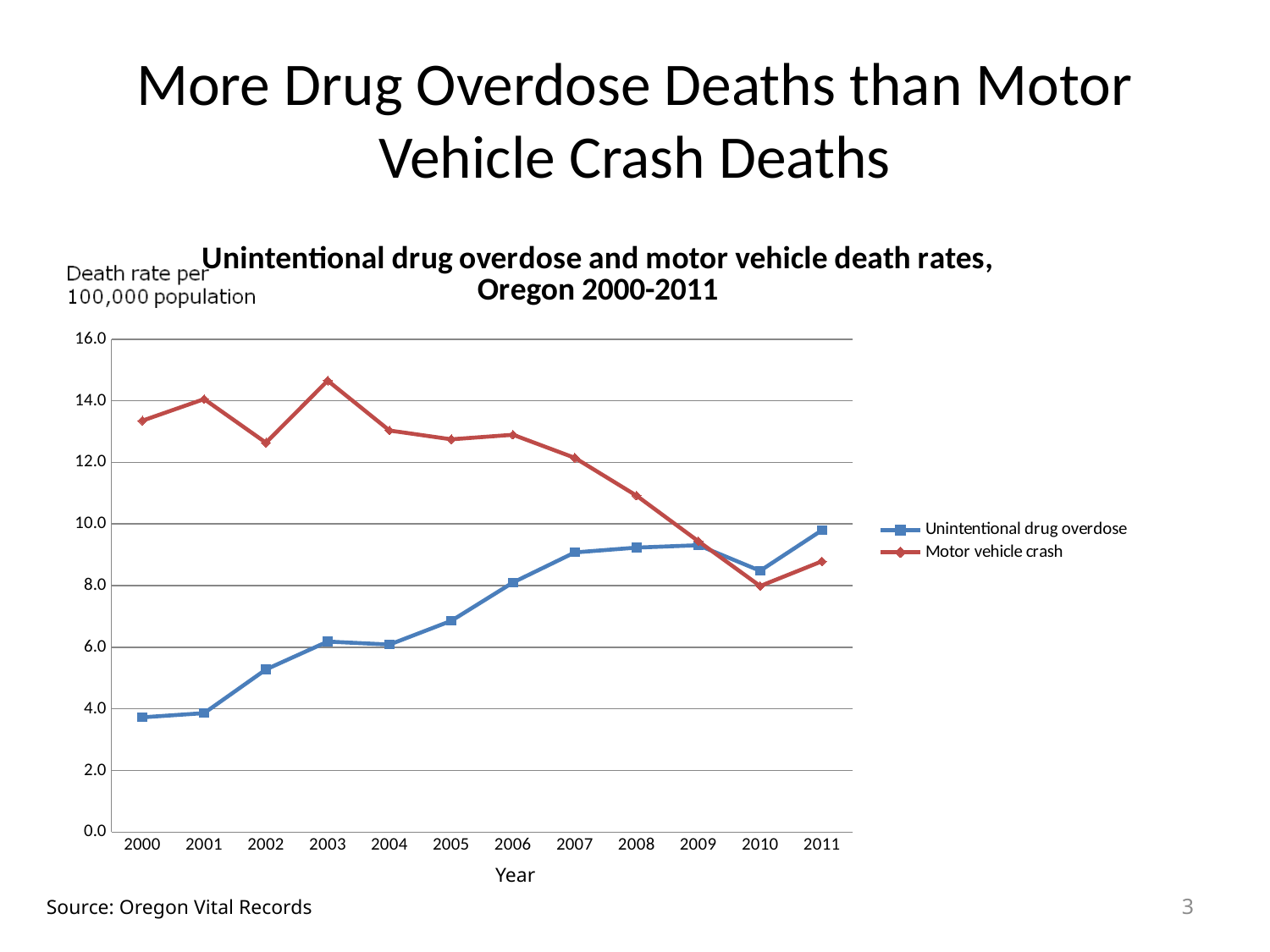
What is the label on the y axis of the chart? Death rate per 100,000 population Is the Unintentional drug overdose death rate in 2000 greater or less than 4.0? less What kind of chart is shown on the slide? line chart Is the Motor vehicle crash death rate in 2003 greater or less than 14.0? greater How many series does the legend list? 2 How many years are plotted along the x axis? 12 In which year is the Motor vehicle crash death rate lowest? 2010 In which year is the Motor vehicle crash death rate highest? 2003 In which year is the Unintentional drug overdose death rate lowest? 2000 In 2011, which series has the higher death rate, Unintentional drug overdose or Motor vehicle crash? Unintentional drug overdose In which year is the Unintentional drug overdose death rate highest? 2011 Does the Motor vehicle crash death rate rise or fall from 2003 to 2010? fall